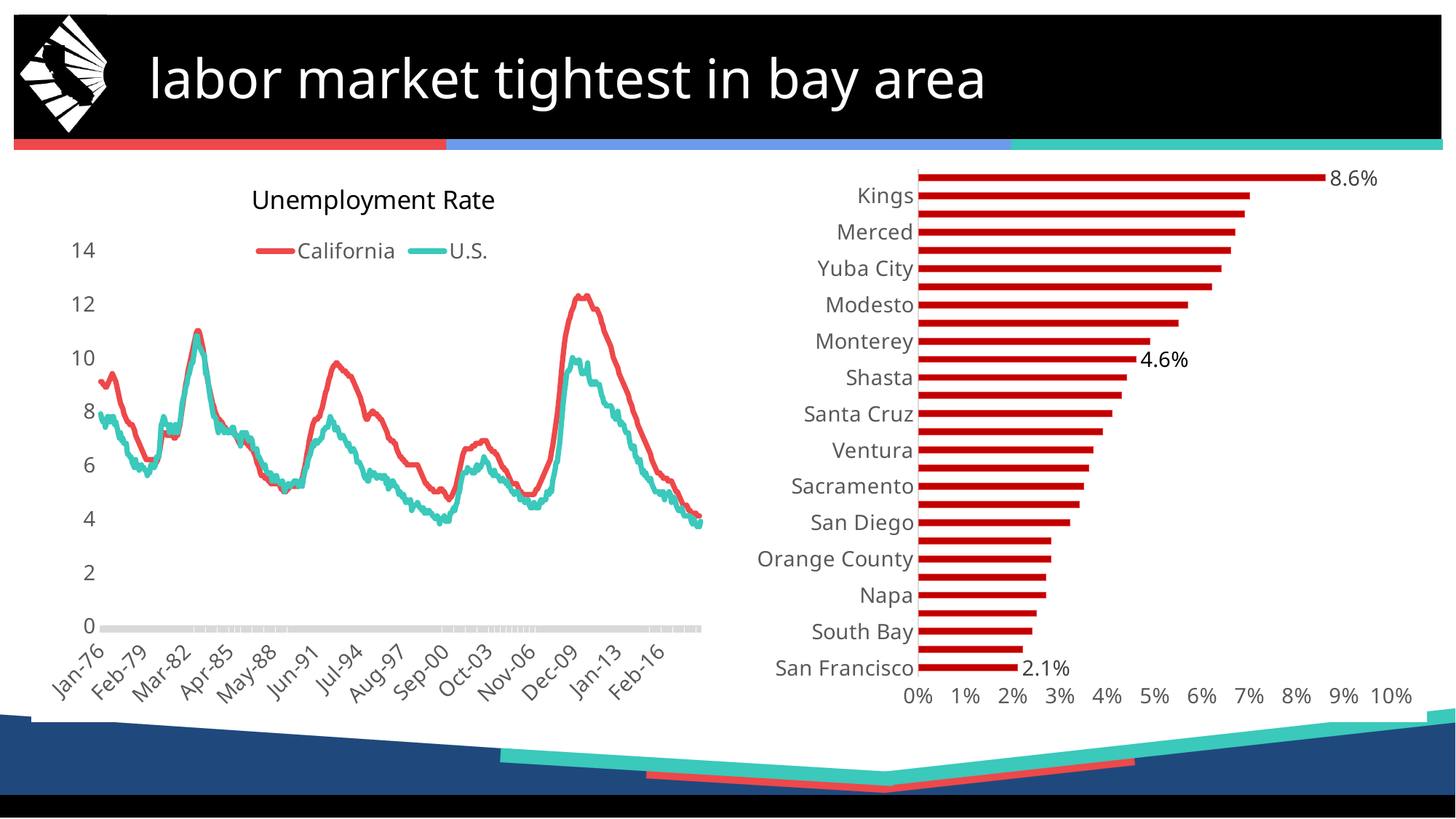
In the bar chart on the right, is the value for San Diego greater or less than 4%? less What type of chart is the Unemployment Rate chart on the left? line chart In the bar chart on the right, which labeled category has the lowest value? San Francisco In the Unemployment Rate chart, which series is higher around Dec-09, California or U.S.? California In the bar chart on the right, is the value for Kings greater or less than 6%? greater In the bar chart on the right, which is larger, Kings or San Francisco? Kings In the bar chart on the right, what is the value for San Francisco? 2.1% What type of chart is the chart on the right of the slide? bar chart In the Unemployment Rate chart, is the California peak around Dec-09 greater or less than 10? greater In the bar chart on the right, what is the value printed on the longest bar at the top? 8.6% What are the two series named in the legend of the Unemployment Rate chart? California and U.S. How many series does the legend of the Unemployment Rate chart list? 2